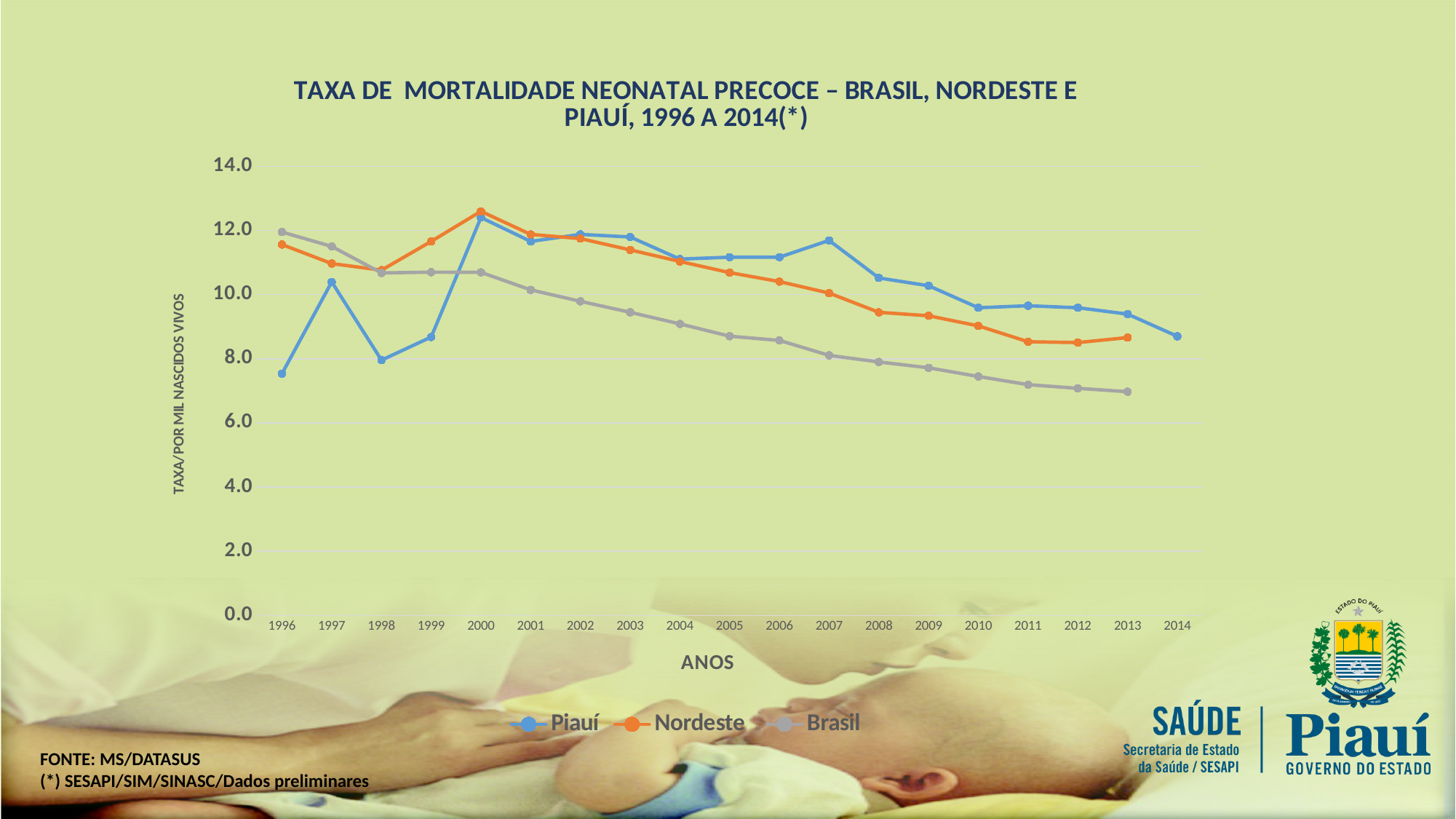
Is the value for Nordeste in 2000 greater or less than 12.0? greater How many years are shown on the x axis? 19 In which year does the Brasil series reach its highest value? 1996 In 1996, which series has the higher value, Piauí or Brasil? Brasil In which year does the Piauí series reach its lowest value? 1996 How many series does the legend list? 3 In 2010, which series has the higher value, Piauí or Brasil? Piauí Does the Brasil series rise or fall from 1996 to 2013? Falls Is the value for Piauí in 1996 greater or less than 8.0? less What is the label of the y axis? TAXA/POR MIL NASCIDOS VIVOS What kind of chart is shown on the slide? Line chart Is the value for Brasil in 2013 greater or less than 8.0? less